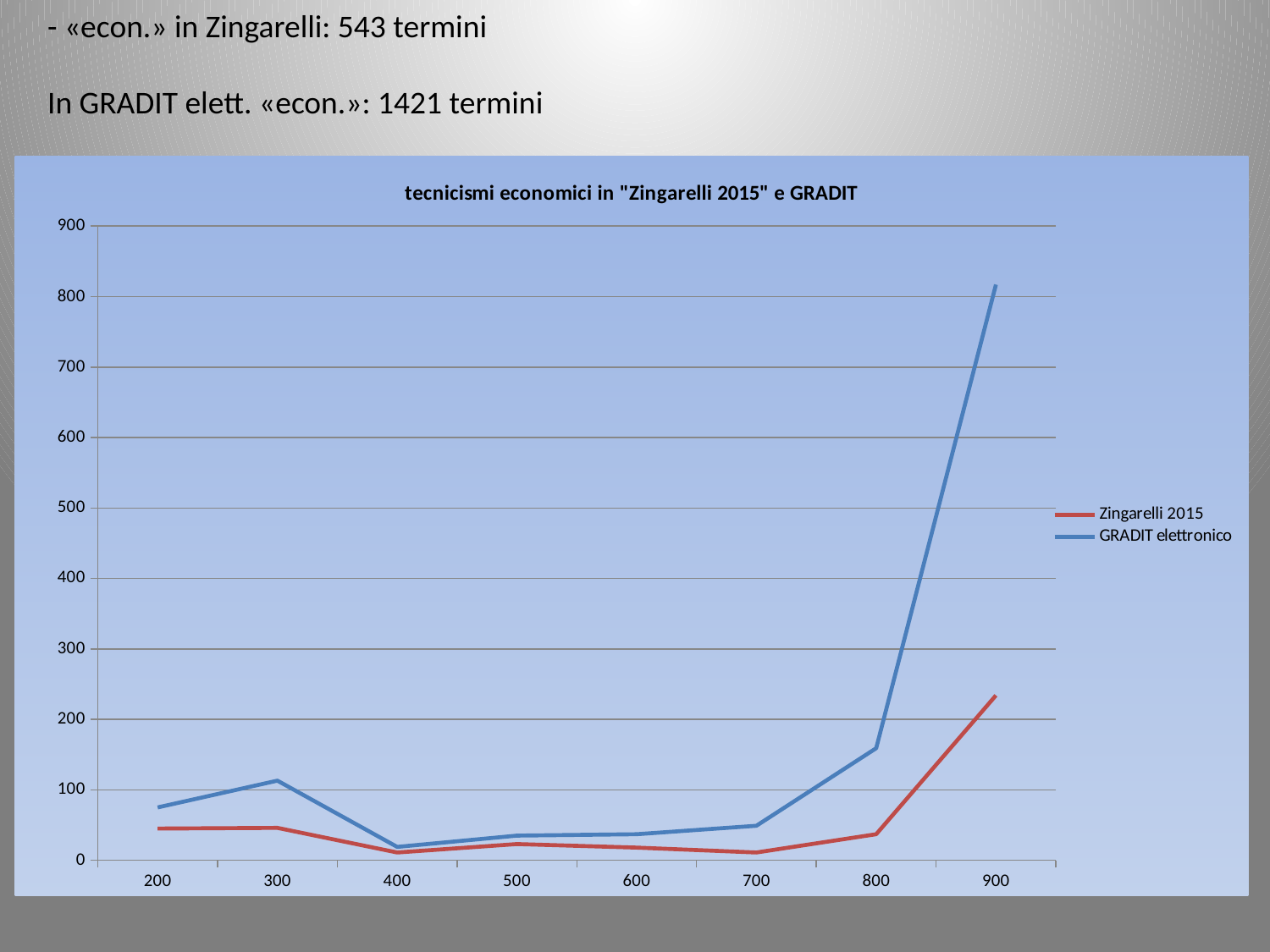
Is the value for Zingarelli 2015 at 900 greater or less than 300? less Does the GRADIT elettronico series rise or fall between 800 and 900? rise What is the title of the chart? tecnicismi economici in "Zingarelli 2015" e GRADIT What kind of chart is shown on the slide? line chart Is the value for GRADIT elettronico at 300 greater or less than 100? greater Is the value for GRADIT elettronico at 900 greater or less than 700? greater How many points are plotted along the x axis for each series? 8 At which x-axis value does the GRADIT elettronico series reach its lowest point? 400 At which x-axis value does the GRADIT elettronico series reach its highest point? 900 How many series does the legend list? 2 At 800, which series has the higher value, Zingarelli 2015 or GRADIT elettronico? GRADIT elettronico At which x-axis value does the Zingarelli 2015 series reach its highest point? 900